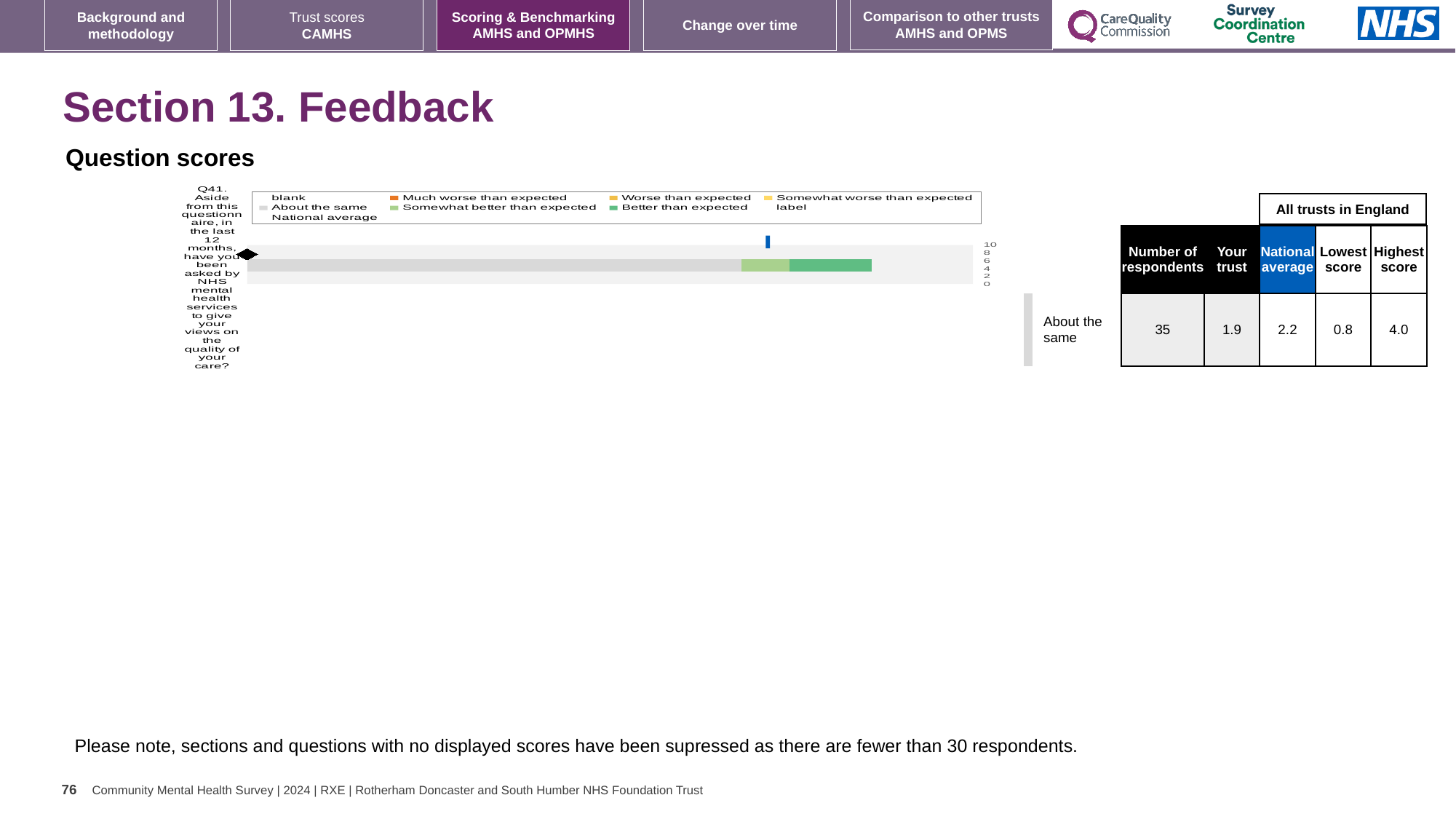
What is the National average score for Q41? 2.2 Which question is plotted in the Question scores chart? Q41 How many entries does the legend of the Question scores chart list? 9 What is the highest value shown on the axis of the Question scores chart? 10 What is the difference between the Highest score and the Lowest score for Q41? 3.2 How many respondents answered Q41? 35 What kind of chart is shown under 'Question scores'? bar chart Is the National average marker for Q41 on the chart greater or less than 4? less Which is larger for Q41, the 'Your trust' score or the National average? National average What is the 'Your trust' score for Q41? 1.9 How many questions (categories) are plotted in the Question scores chart? 1 What benchmark rating is given for Q41 in the Question scores chart? About the same